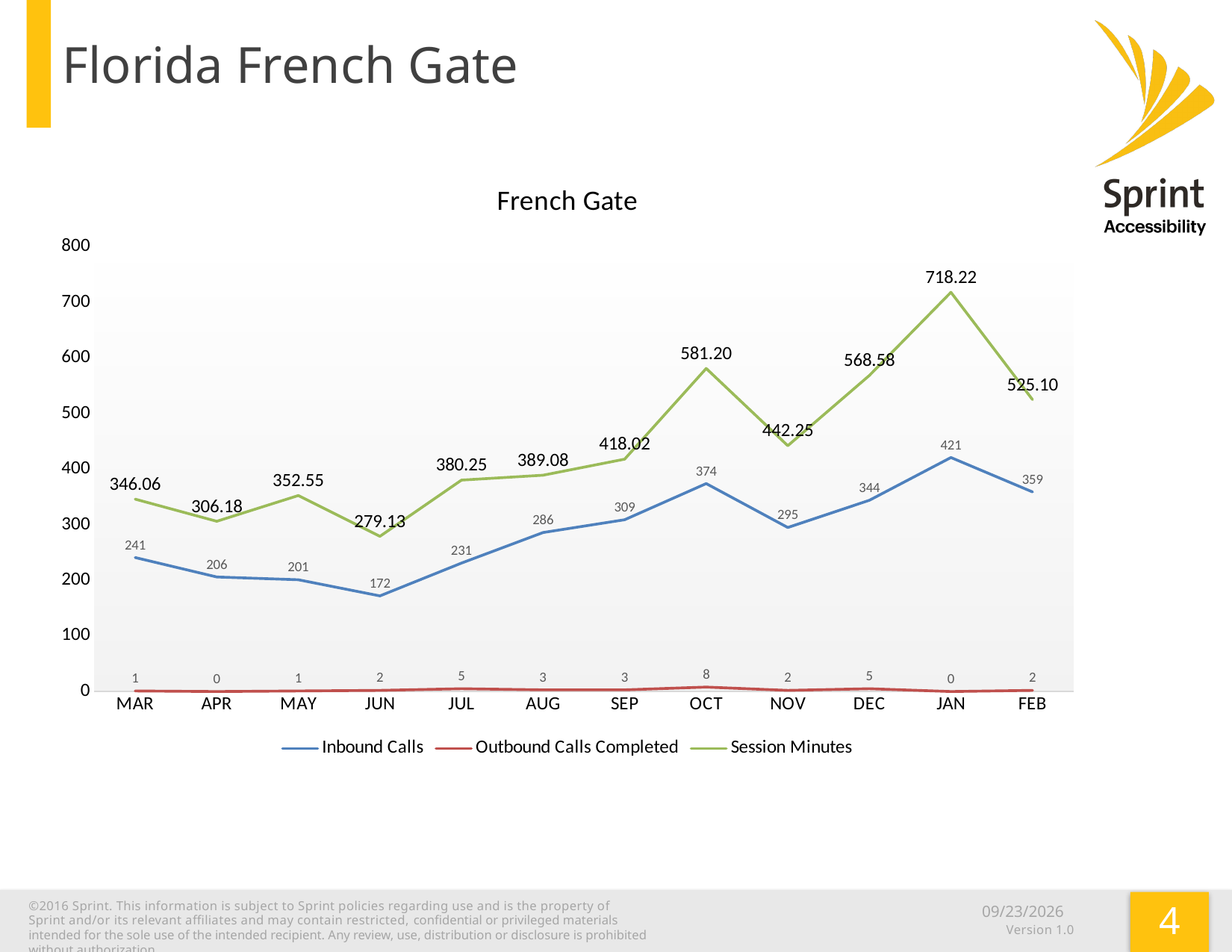
In which month are Inbound Calls lowest? JUN How many months are shown on the x axis? 12 Which is larger: Session Minutes in OCT or Session Minutes in DEC? OCT What is the value of Inbound Calls in JUN? 172 What kind of chart is shown on the slide? Line chart What is the difference between Inbound Calls in JAN and in FEB? 62 In which month are Session Minutes highest? JAN What is the title of the chart? French Gate What is the value of Outbound Calls Completed in OCT? 8 What is the value of Session Minutes in JAN? 718.22 Do Inbound Calls rise or fall from JUN to OCT? Rise How many series does the legend list? 3